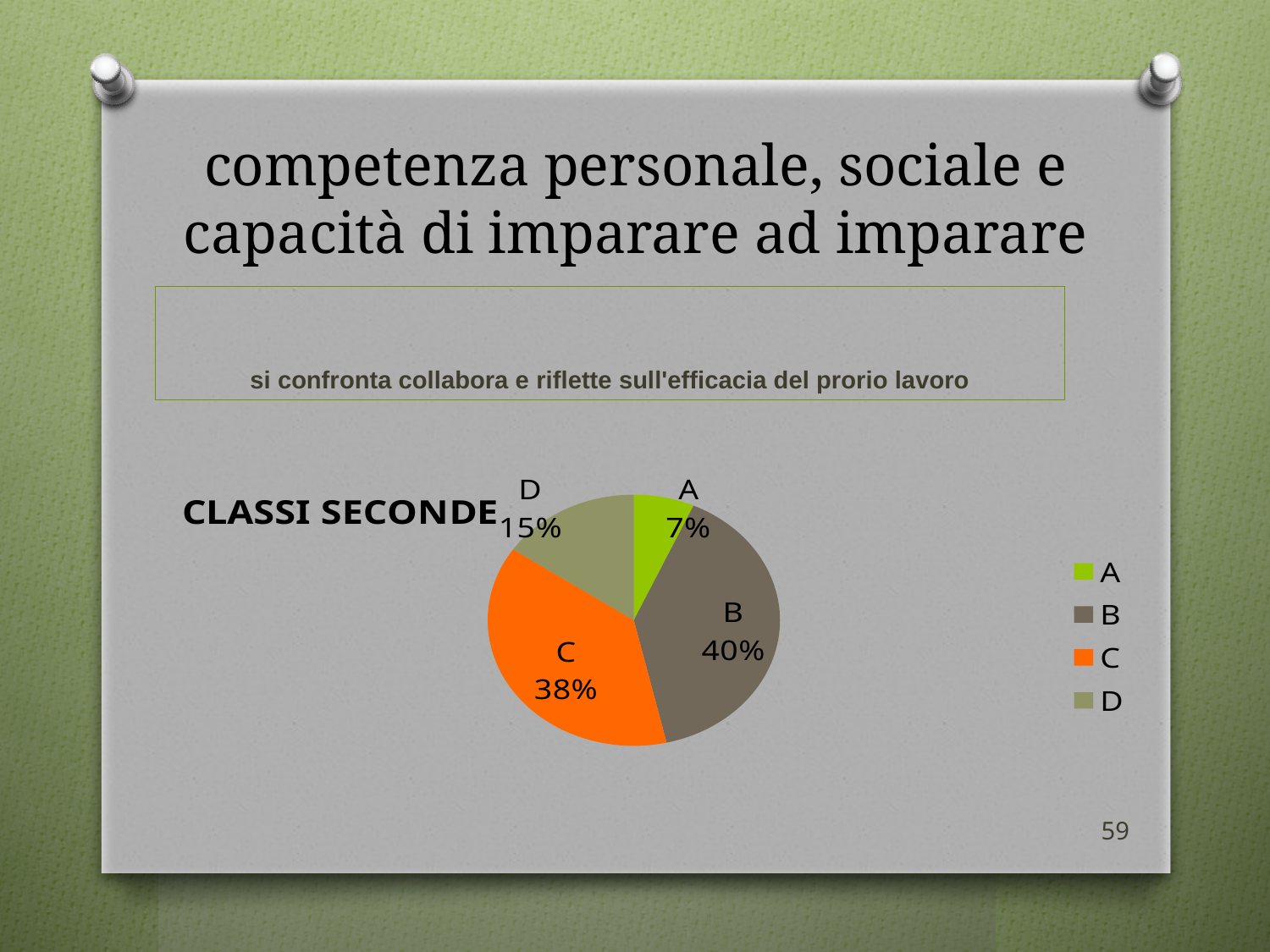
Which is larger in the pie chart, the value for C or the value for D? C Which slice of the pie chart is the largest? B What is the difference between the values for D and A in the pie chart? 8% What is the value for slice D in the pie chart? 15% What kind of chart is shown on the slide? pie chart What label appears to the left of the pie chart? CLASSI SECONDE What is the value for slice C in the pie chart? 38% What is the value for slice B in the pie chart? 40% What is the difference between the values for B and C in the pie chart? 2% How many slices does the pie chart have? 4 What is the value for slice A in the pie chart? 7% Which slice of the pie chart is the smallest? A